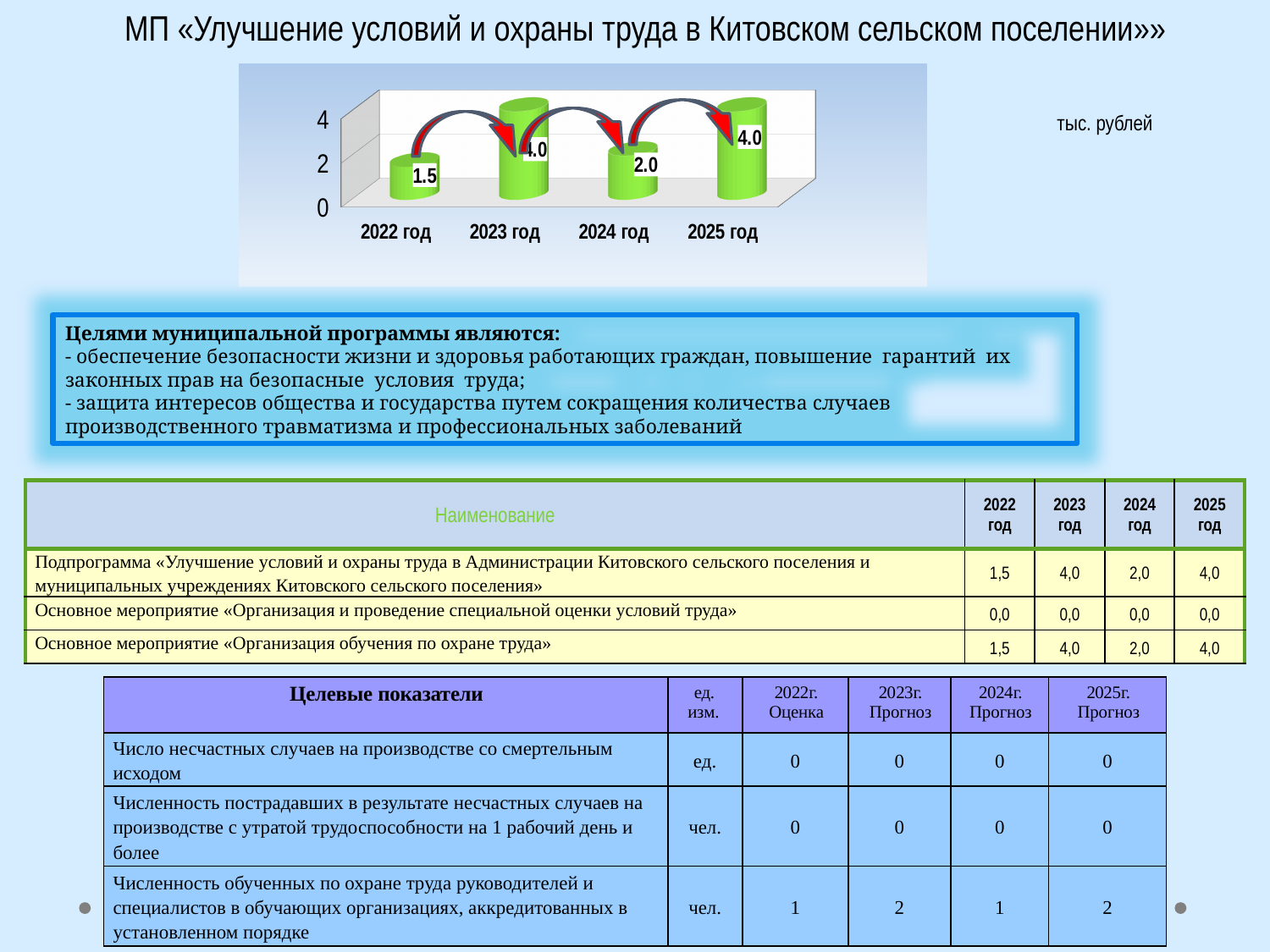
What unit label is shown next to the chart? тыс. рублей What is the difference between the values for 2023 год and 2022 год? 2.5 Which year has the lowest value in the chart? 2022 год What kind of chart is shown on the slide? bar chart Is the value for 2022 год greater or less than 2? less What is the value shown for 2022 год in the chart? 1.5 What is the value shown for 2025 год in the chart? 4.0 Which is larger, the value for 2022 год or the value for 2024 год? 2024 год How many years (categories) are shown in the chart? 4 What is the difference between the values for 2024 год and 2022 год? 0.5 What is the value shown for 2023 год in the chart? 4.0 What is the value shown for 2024 год in the chart? 2.0